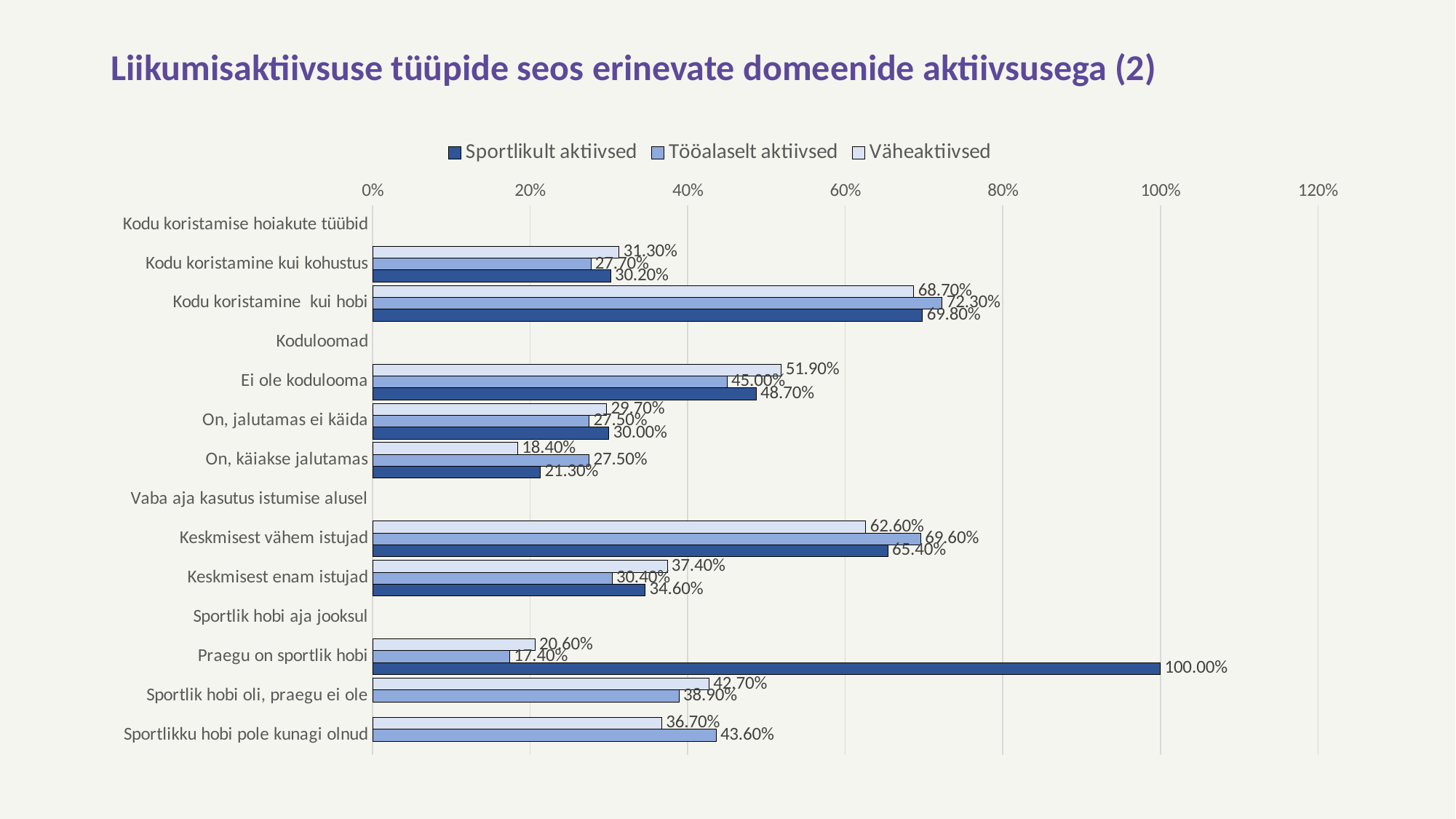
In the category 'Sportlik hobi oli, praegu ei ole', which is larger: the Väheaktiivsed value or the Tööalaselt aktiivsed value? Väheaktiivsed What is the difference between the Tööalaselt aktiivsed and Väheaktiivsed values in the category 'Sportlikku hobi pole kunagi olnud'? 6.90% What is the title of the chart on the slide? Liikumisaktiivsuse tüüpide seos erinevate domeenide aktiivsusega (2) Which series has the highest value in the category 'Keskmisest enam istujad'? Väheaktiivsed How many series does the legend list? 3 What is the value for Väheaktiivsed in the category 'Ei ole kodulooma'? 51.90% What is the value for Sportlikult aktiivsed in the category 'Keskmisest vähem istujad'? 65.40% Which series has the lowest value in the category 'On, käiakse jalutamas'? Väheaktiivsed What type of chart is shown on the slide? bar chart What is the value for Tööalaselt aktiivsed in the category 'Kodu koristamine kui hobi'? 72.30% What is the value for Sportlikult aktiivsed in the category 'Praegu on sportlik hobi'? 100.00% Is the Tööalaselt aktiivsed value for 'Keskmisest vähem istujad' greater or less than 60%? greater